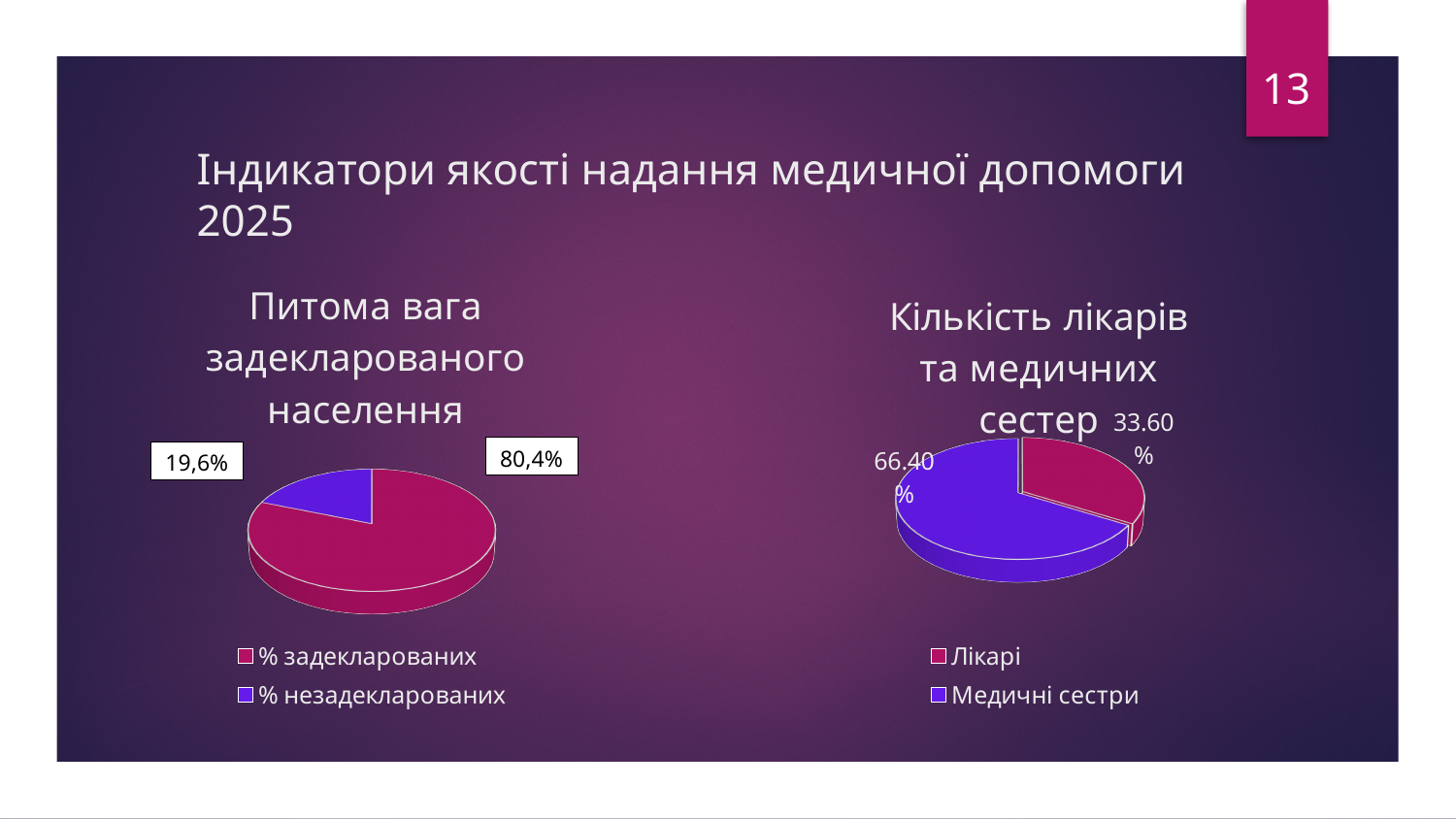
In the chart titled "Питома вага задекларованого населення", what is the difference between "% задекларованих" and "% незадекларованих"? 60,8% In the chart titled "Питома вага задекларованого населення", what is the value for "% задекларованих"? 80,4% What type of chart is the one titled "Кількість лікарів та медичних сестер"? Pie chart How many entries does the legend of the chart titled "Кількість лікарів та медичних сестер" list? 2 In the chart titled "Кількість лікарів та медичних сестер", what colour is the "Медичні сестри" slice? Blue/purple In the chart titled "Кількість лікарів та медичних сестер", what is the value for "Лікарі"? 33.60% In the chart titled "Питома вага задекларованого населення", which category has the largest slice? % задекларованих In the chart titled "Питома вага задекларованого населення", what is the value for "% незадекларованих"? 19,6% In the chart titled "Кількість лікарів та медичних сестер", what is the value for "Медичні сестри"? 66.40% How many slices does the chart titled "Питома вага задекларованого населення" have? 2 In the chart titled "Кількість лікарів та медичних сестер", which category has the smallest slice? Лікарі In the chart titled "Кількість лікарів та медичних сестер", which is larger: "Лікарі" or "Медичні сестри"? Медичні сестри